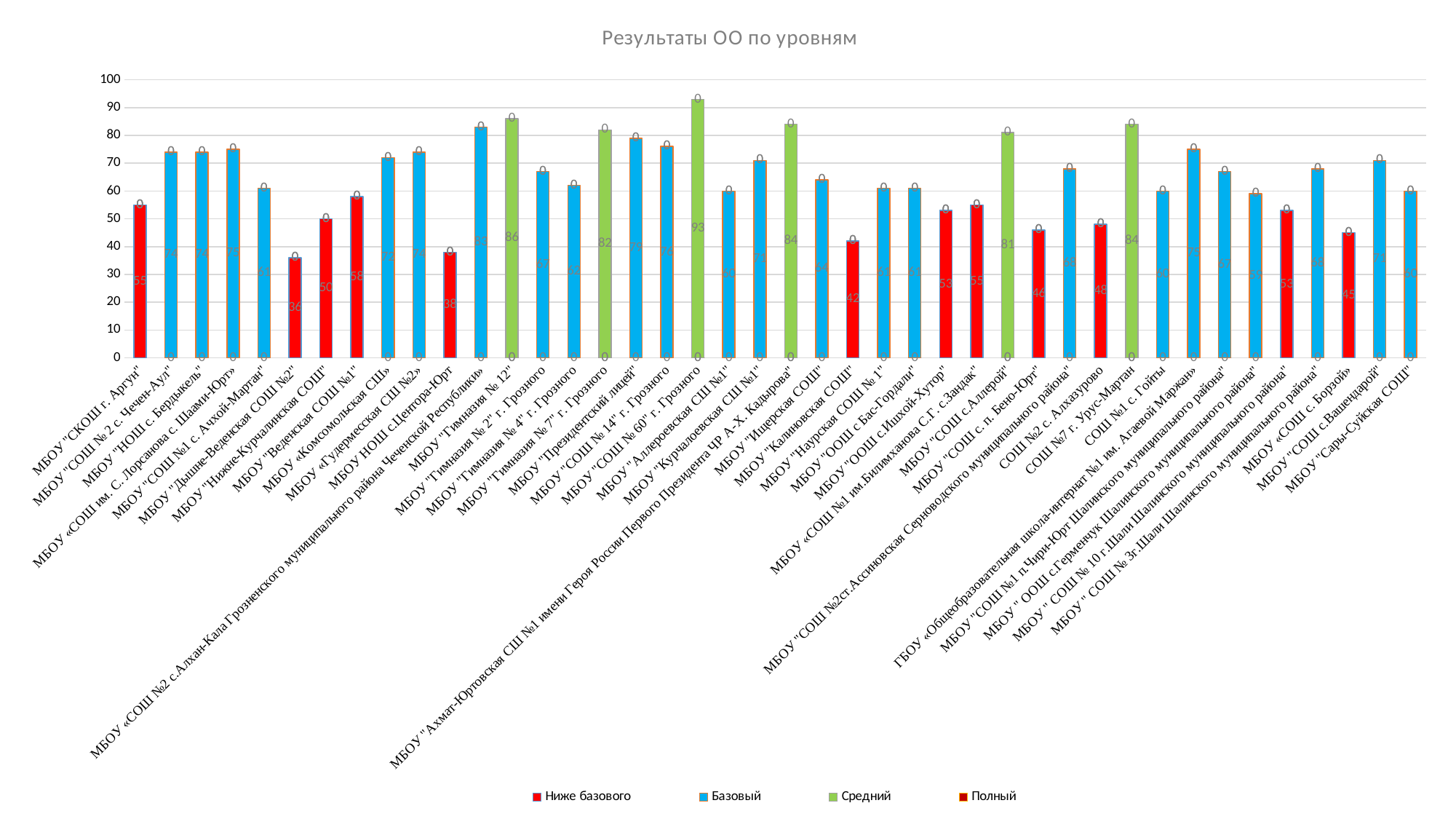
What is the value for МБОУ "Гимназия № 12"? 86 Which has the larger value: МБОУ "Президентский лицей" or МБОУ "СОШ № 14" г. Грозного? МБОУ "Президентский лицей" What is the title of the chart? Результаты ОО по уровням What colour represents the series "Средний" in the legend? green Which school has the highest value in the chart? МБОУ "СОШ № 60" г. Грозного Which school has the lowest value in the chart? МБОУ "Дышне-Веденская СОШ №2" Is the value for МБОУ «СОШ с. Борзой» greater or less than 50? less What is the value for МБОУ "Калиновская СОШ"? 42 What kind of chart is shown on the slide? bar chart How many series does the legend list? 4 What is the value for МБОУ "СОШ с.Аллерой"? 81 What is the difference between the values for МБОУ "СОШ № 60" г. Грозного and МБОУ "Гимназия № 12"? 7